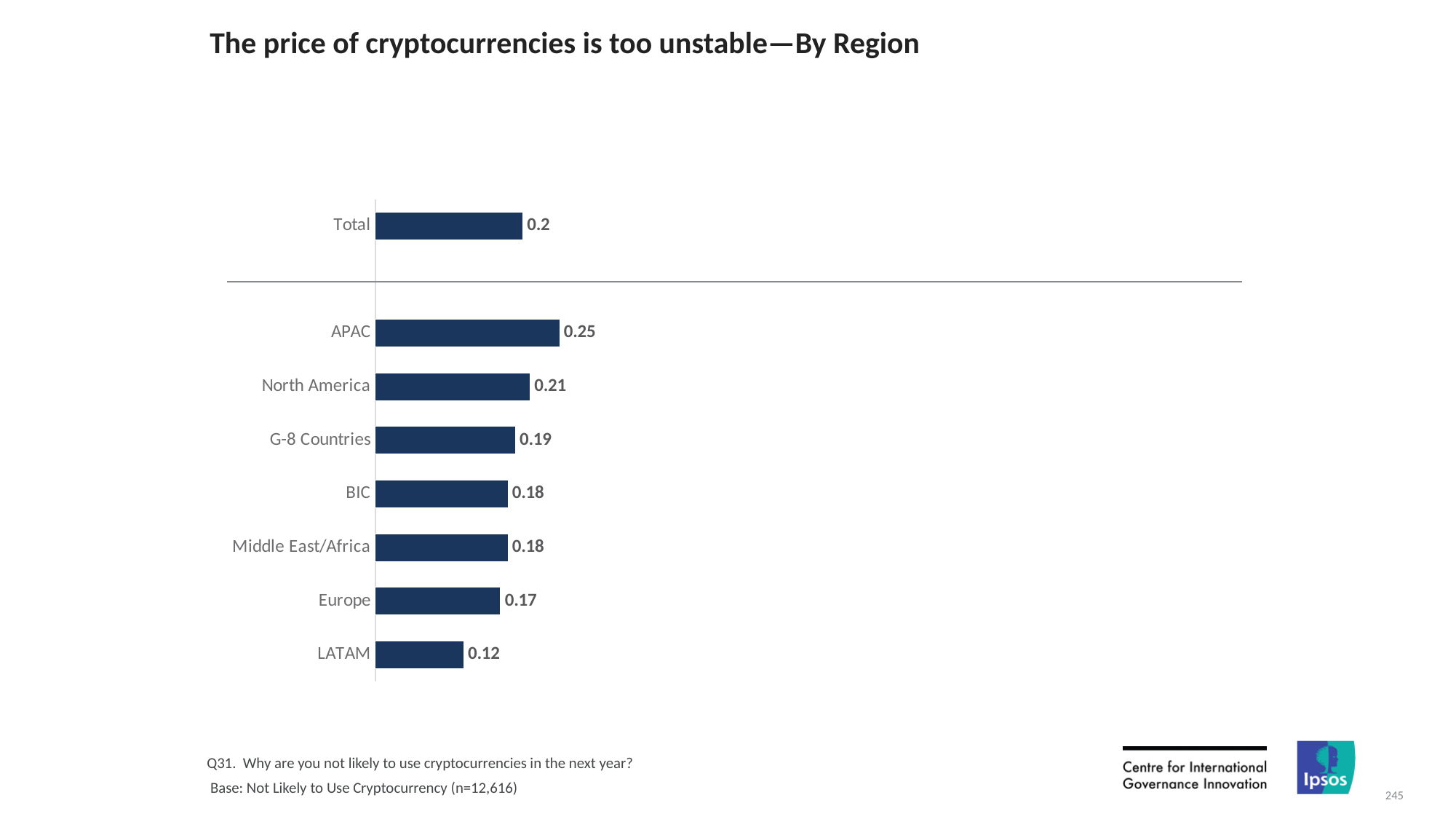
Which region has the highest value? APAC How many bars are plotted on the chart? 8 What is the difference between the values for North America and Europe? 0.04 What is the value for Europe? 0.17 What is the difference between the values for APAC and LATAM? 0.13 What is the value for Total? 0.2 What is the value for APAC? 0.25 Which is larger, the value for North America or the value for G-8 Countries? North America What is the title of the chart? The price of cryptocurrencies is too unstable—By Region What is the value for LATAM? 0.12 What kind of chart is shown on the slide? Bar chart Which region has the lowest value? LATAM